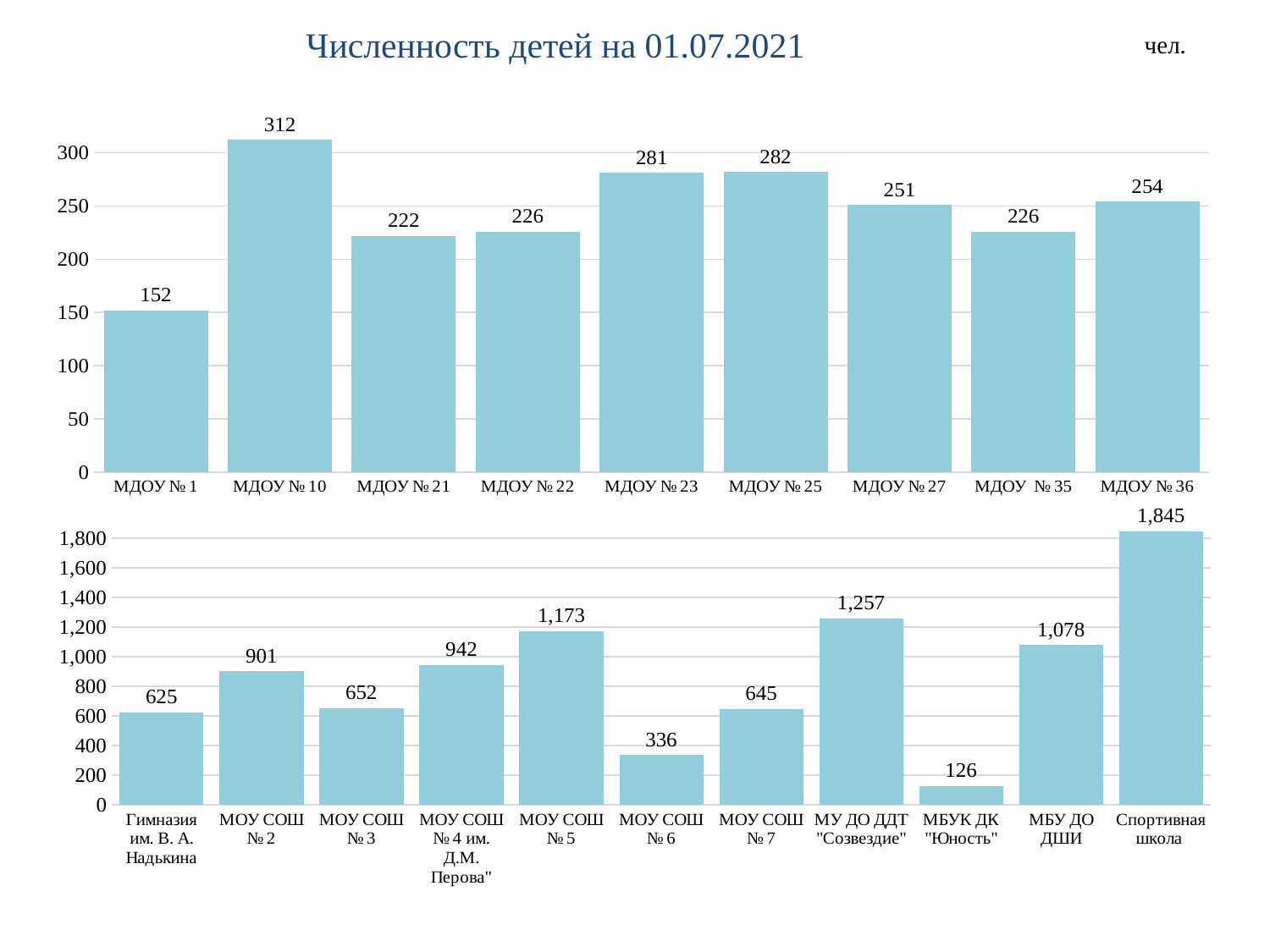
In the top chart, what is the difference between the values for МДОУ № 10 and МДОУ № 1? 160 In the top chart, what is the value for МДОУ № 10? 312 In the bottom chart, which is larger: the value for МОУ СОШ № 5 or МОУ СОШ № 2? МОУ СОШ № 5 In the top chart, what is the value for МДОУ № 27? 251 How many categories are shown in the bottom chart? 11 In the top chart, which category has the lowest value? МДОУ № 1 In the bottom chart, what is the value for МОУ СОШ № 6? 336 In the bottom chart, which category has the lowest value? МБУК ДК "Юность" What type of chart is the top chart? Bar chart In the bottom chart, what is the value for МУ ДО ДДТ "Созвездие"? 1,257 In the bottom chart, which category has the highest value? Спортивная школа In the top chart, which category has the highest value? МДОУ № 10